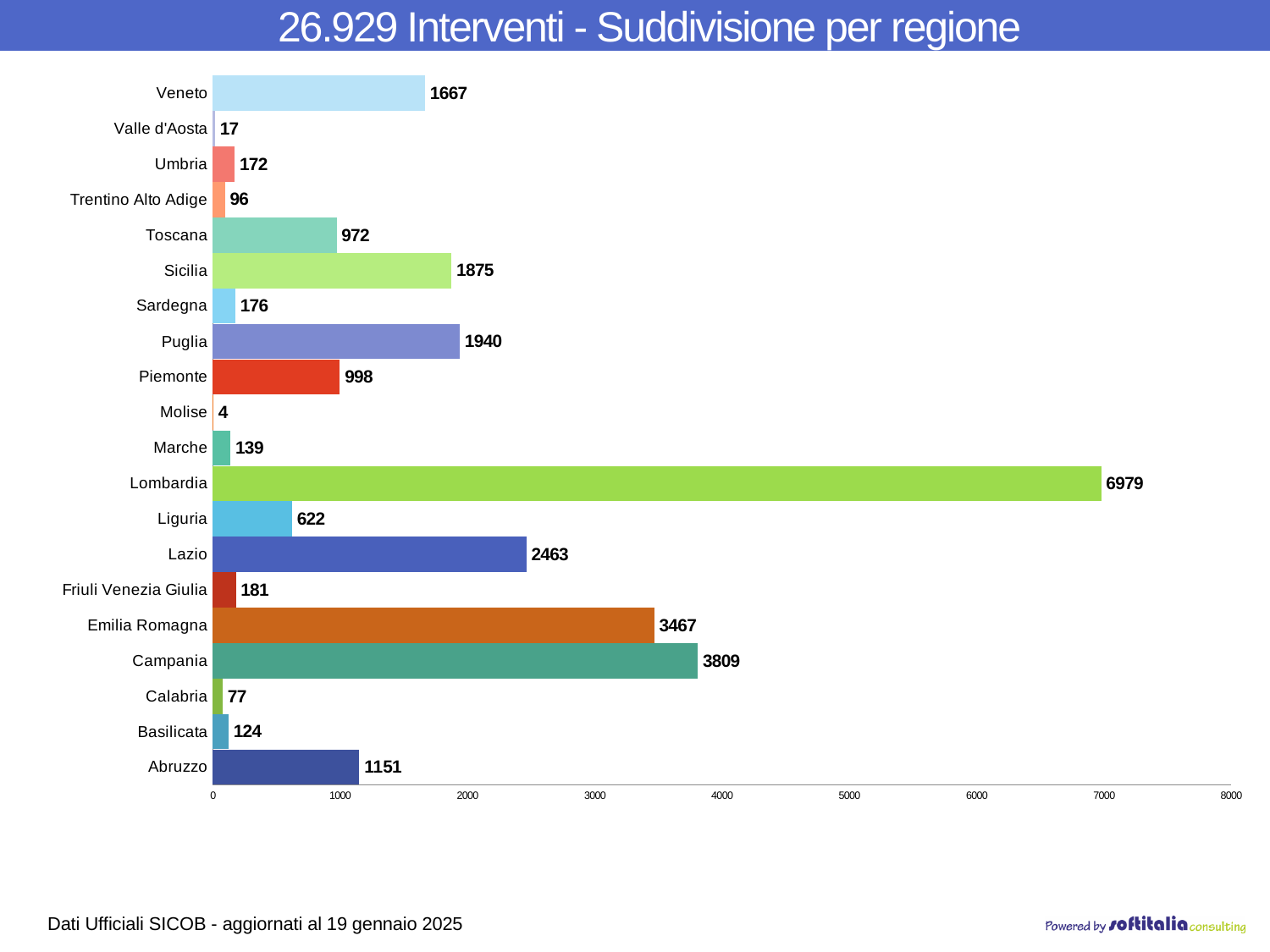
What is the title of the chart? 26.929 Interventi - Suddivisione per regione How many regions are shown in the chart? 20 What is the difference between the values for Campania and Emilia Romagna? 342 Which region has the highest value? Lombardia Which is larger, the value for Puglia or the value for Sicilia? Puglia What kind of chart is shown on the slide? bar chart Which region has the lowest value? Molise What is the value for Lombardia? 6979 Is the value for Lazio greater or less than 2000? greater What is the value for Valle d'Aosta? 17 What is the difference between the values for Lazio and Veneto? 796 What is the value for Emilia Romagna? 3467